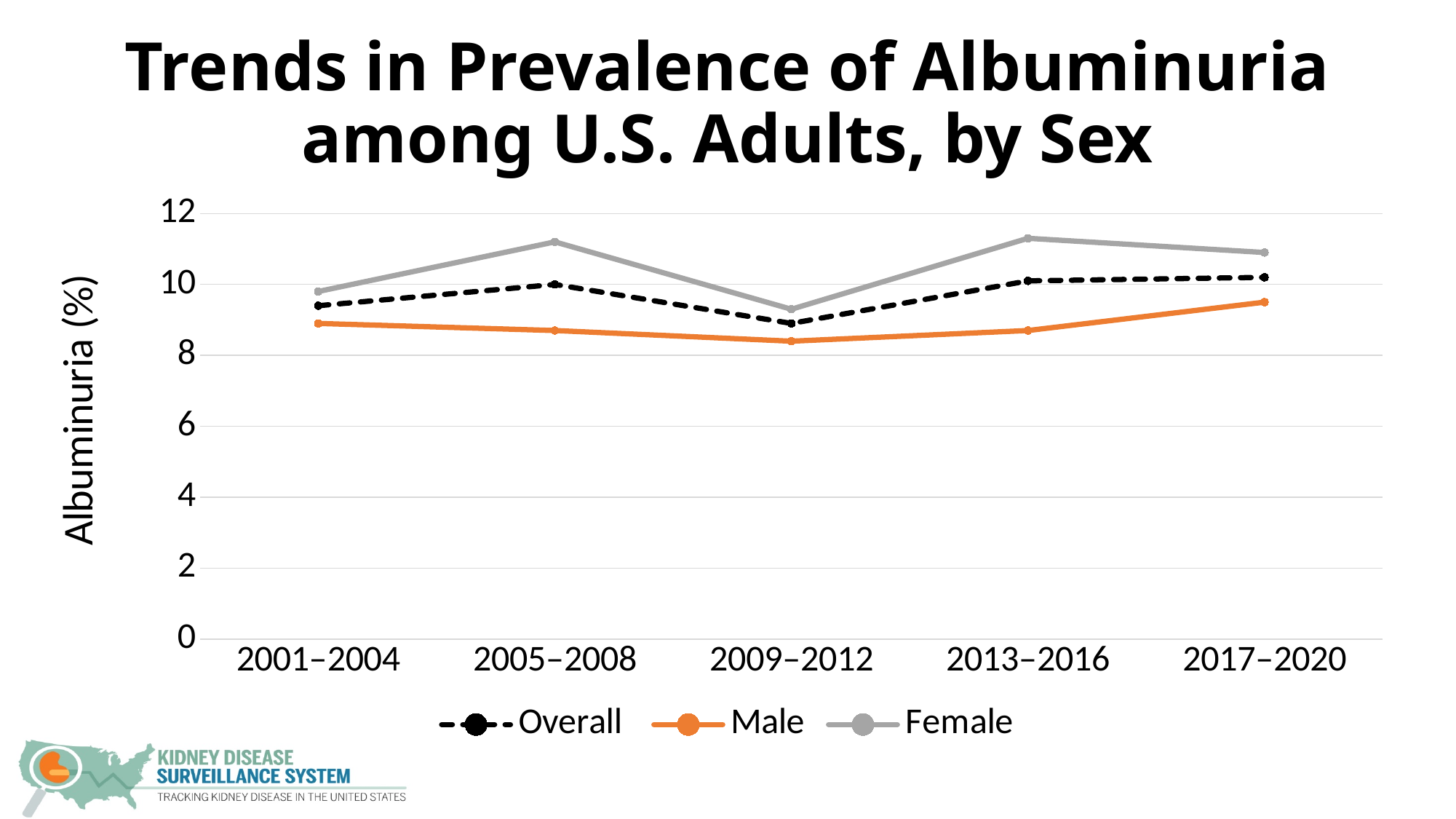
Is the Overall value for 2009–2012 greater or less than 10? less What is the label on the y axis? Albuminuria (%) Which series has the highest albuminuria prevalence in 2009–2012? Female Does the Male line rise or fall from 2009–2012 to 2017–2020? rise How many series does the legend list? 3 What kind of chart is shown on the slide? line chart Which is larger in 2013–2016, the Female value or the Male value? Female Is the Female value for 2005–2008 greater or less than 10? greater Which series has the lowest albuminuria prevalence in 2017–2020? Male Which series is drawn with a dashed line? Overall Is the Male value for 2001–2004 greater or less than 10? less How many time periods are shown on the x axis? 5